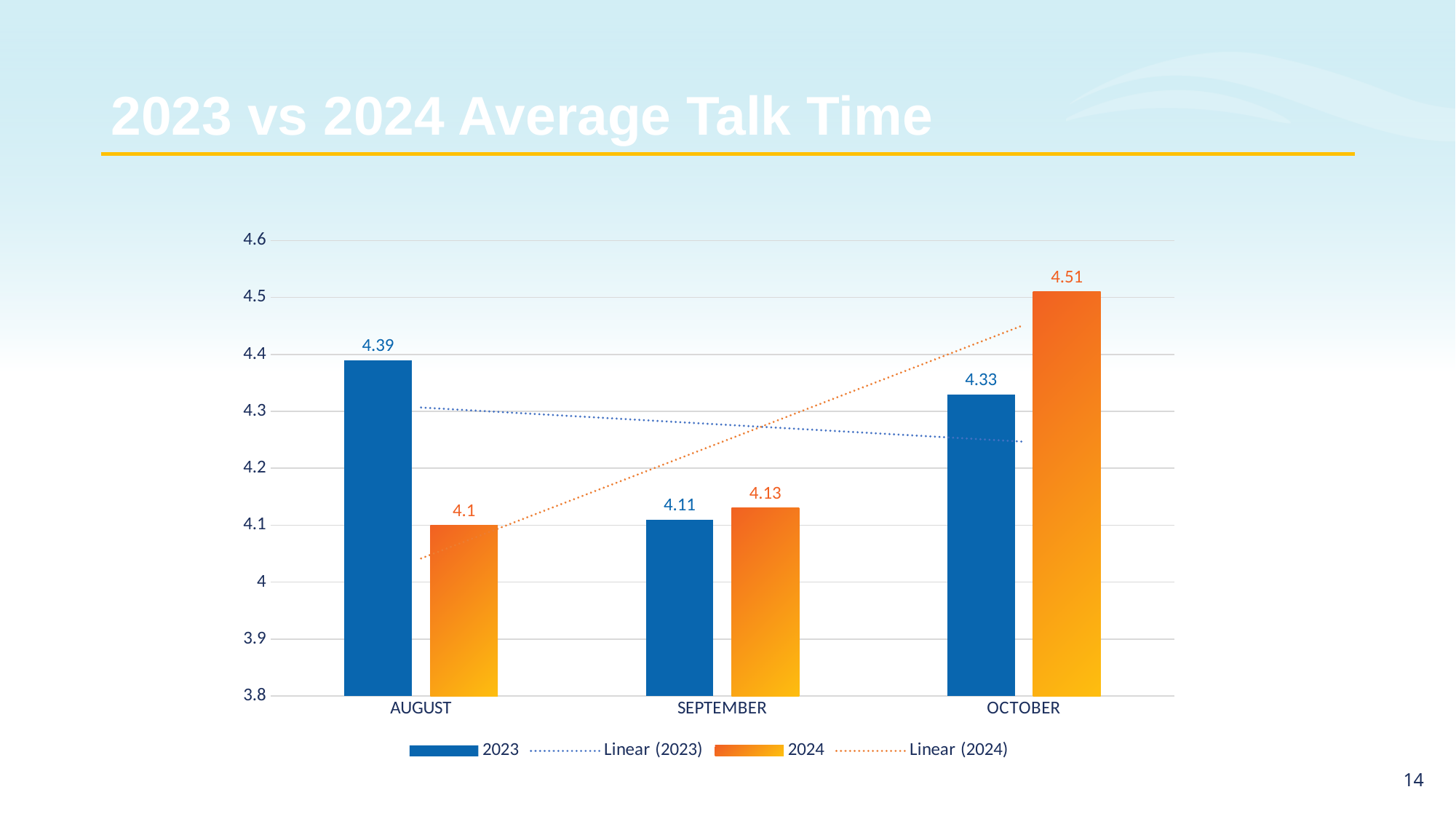
Which is larger for August, the 2023 value or the 2024 value? 2023 Is the 2023 value for October greater or less than 4.4? less Which month has the lowest 2023 value? September What is the 2024 value for October? 4.51 How many months are shown on the x axis? 3 Which month has the highest 2024 value? October What is the difference between the 2024 and 2023 values for October? 0.18 What kind of chart is shown on the slide? Bar chart How many entries does the legend list? 4 What is the 2023 value for August? 4.39 What is the title of the chart on the slide? 2023 vs 2024 Average Talk Time What is the 2024 value for September? 4.13